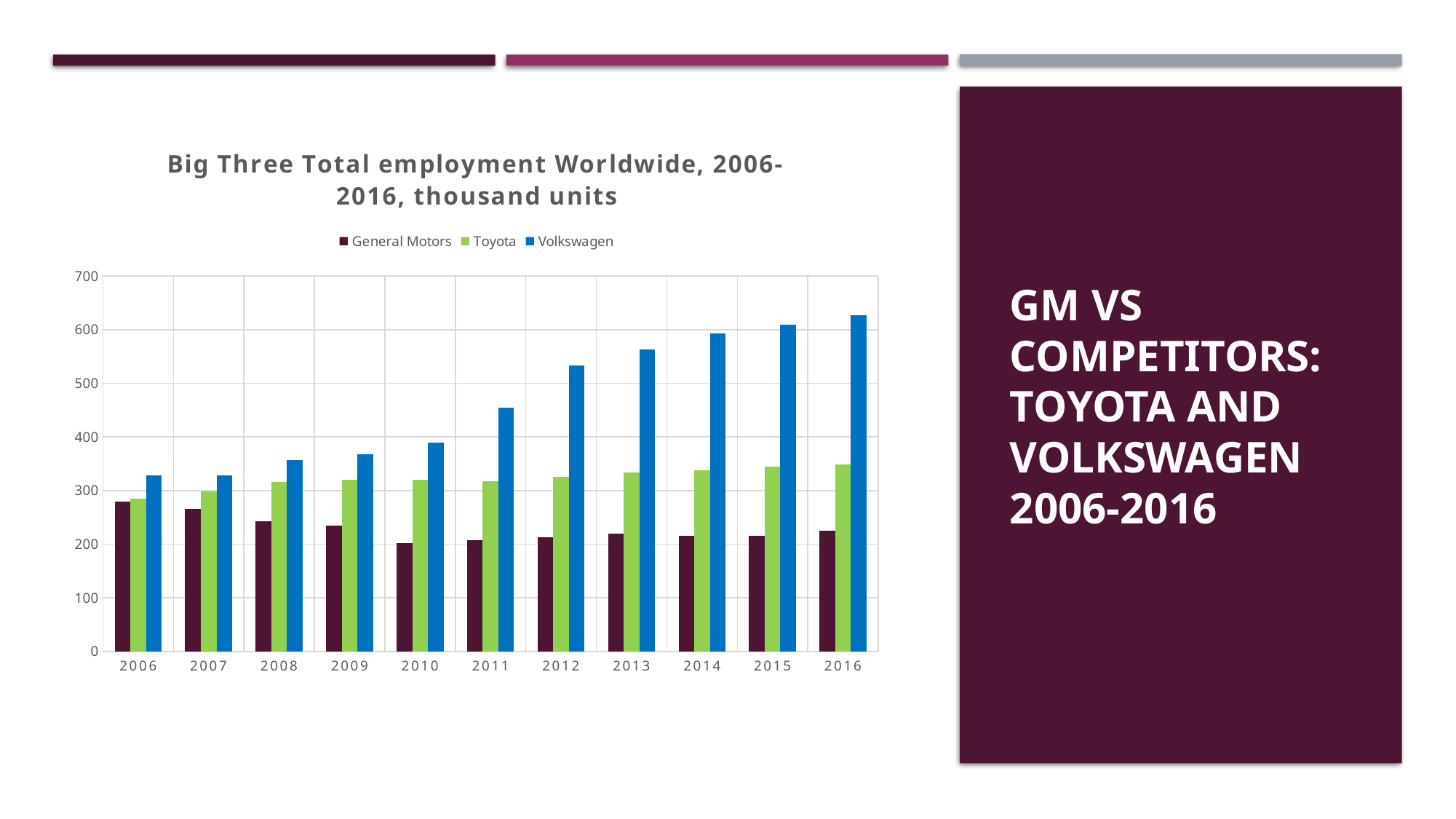
Is the value for General Motors in 2010 greater or less than 250? less How many years are shown on the x axis? 11 In which year is the Volkswagen value highest? 2016 What is the title of the chart? Big Three Total employment Worldwide, 2006-2016, thousand units In 2016, which is larger: Toyota or Volkswagen? Volkswagen Is the value for Volkswagen in 2016 greater or less than 600? greater In which year is the General Motors value highest? 2006 Is the value for Toyota in 2016 greater or less than 400? less What kind of chart is shown on the slide? Bar chart How many series does the legend list? 3 Do the Volkswagen values rise or fall from 2006 to 2016? Rise